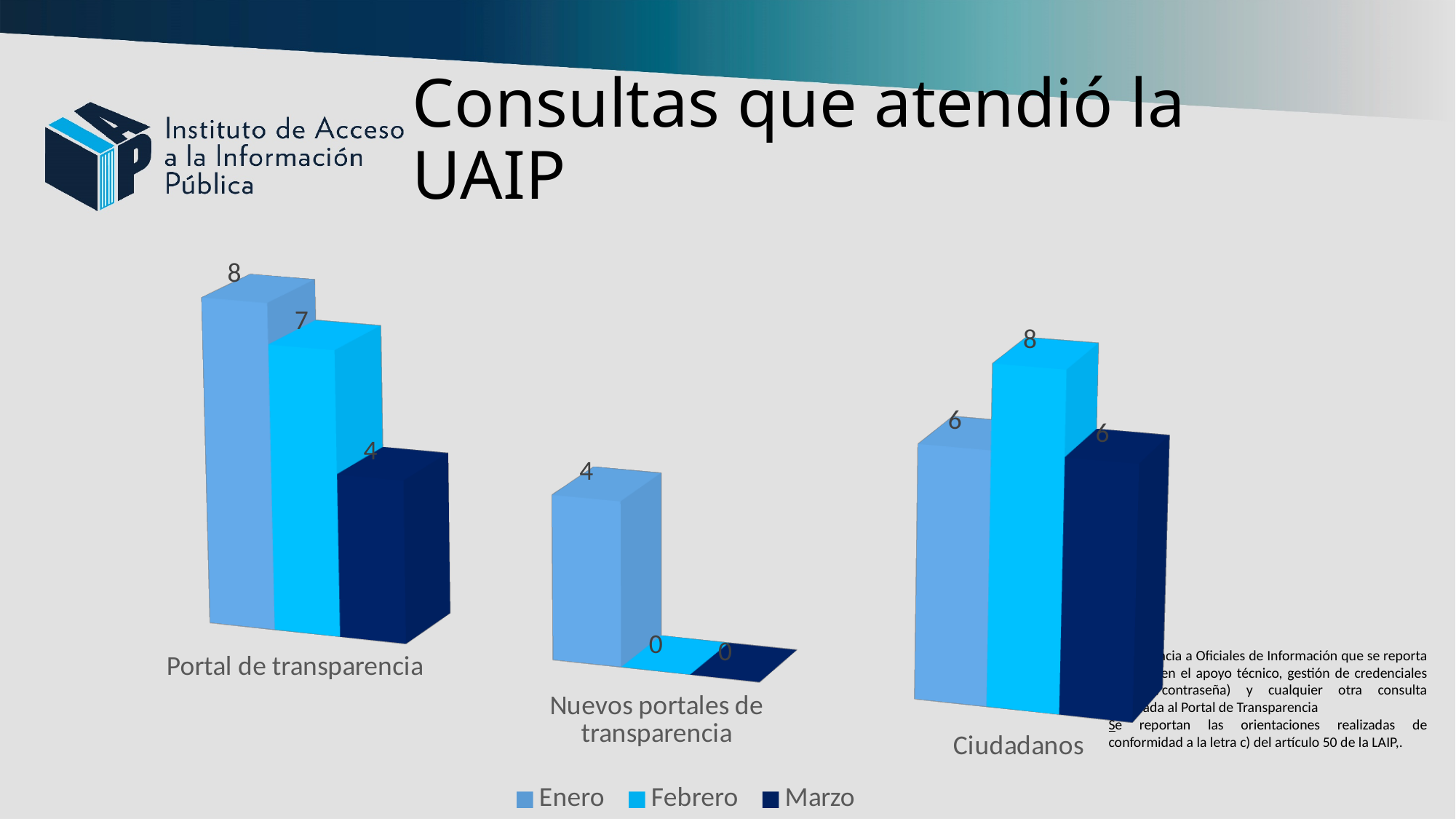
What is the value for Enero in the Portal de transparencia category? 8 What is the difference between the Enero and Marzo values for Portal de transparencia? 4 What is the title of the chart on the slide? Consultas que atendió la UAIP What is the value for Marzo in the Portal de transparencia category? 4 What is the value for Febrero in the Nuevos portales de transparencia category? 0 What kind of chart is shown on the slide? Bar chart How many series does the legend list? 3 Which month has the lowest value in the Ciudadanos category? Enero and Marzo (both 6) Which month has the highest value in the Portal de transparencia category? Enero How many categories are shown on the x axis? 3 What is the value for Febrero in the Ciudadanos category? 8 Which is larger: the Febrero value for Portal de transparencia or the Febrero value for Ciudadanos? Ciudadanos